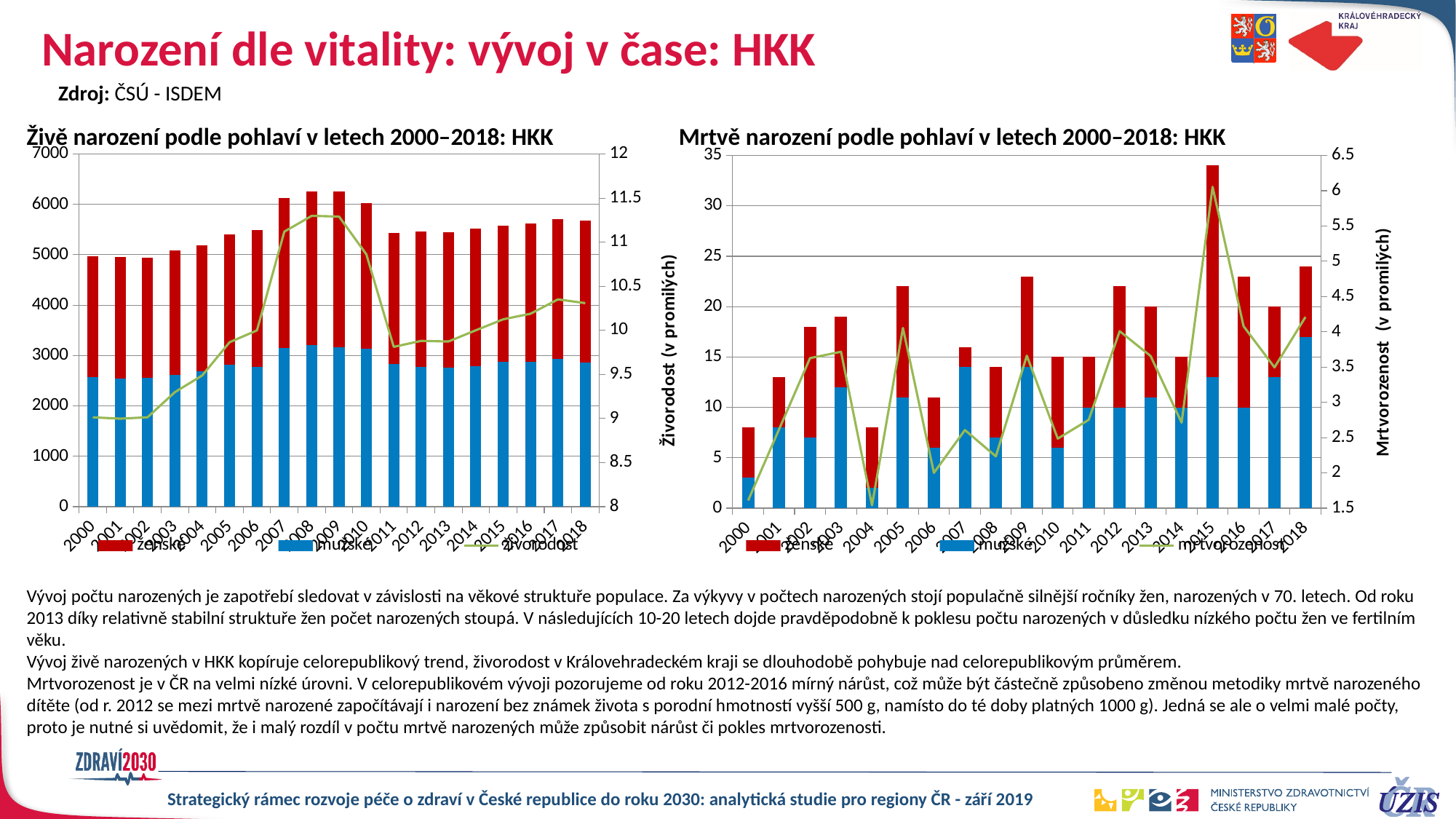
In the chart 'Mrtvě narození podle pohlaví v letech 2000–2018: HKK', is the total bar for 2004 greater or less than 10? less In the chart 'Živě narození podle pohlaví v letech 2000–2018: HKK', is the živorodost line value for 2000 greater or less than 9.5? less In the chart 'Živě narození podle pohlaví v letech 2000–2018: HKK', is the total bar for 2008 greater or less than 6000? greater In the chart 'Živě narození podle pohlaví v letech 2000–2018: HKK', how many series does the legend list? 3 In the chart 'Mrtvě narození podle pohlaví v letech 2000–2018: HKK', which year has the highest total bar? 2015 In the chart 'Živě narození podle pohlaví v letech 2000–2018: HKK', how many years are shown on the x axis? 19 In the chart 'Živě narození podle pohlaví v letech 2000–2018: HKK', do the total bars rise or fall from 2000 to 2008? rise In the chart 'Živě narození podle pohlaví v letech 2000–2018: HKK', which year has the larger total bar, 2000 or 2008? 2008 In the chart 'Mrtvě narození podle pohlaví v letech 2000–2018: HKK', what colour are the 'ženské' bars? red